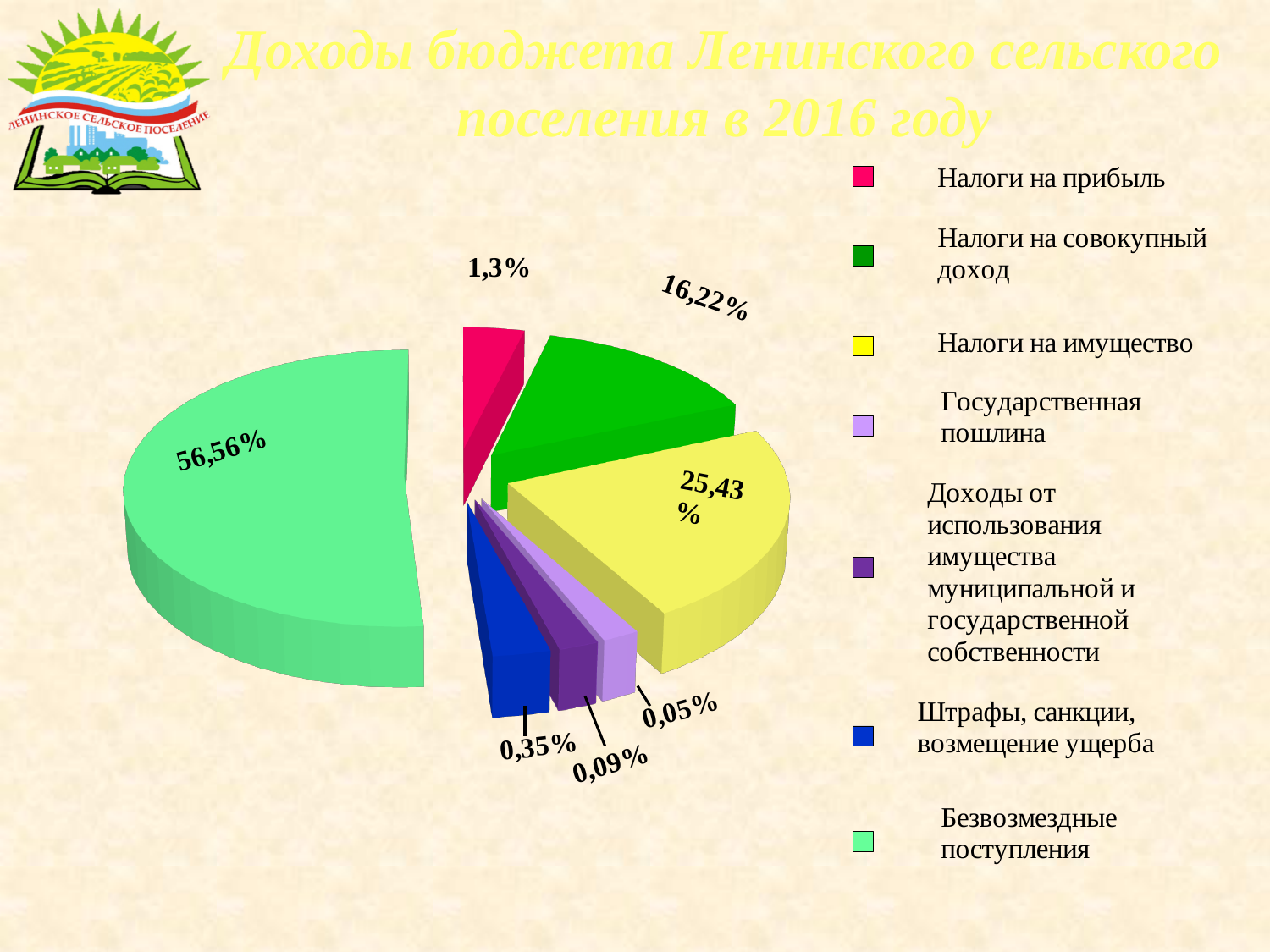
What is the value shown for "Налоги на прибыль"? 1,3% What is the value shown for "Штрафы, санкции, возмещение ущерба"? 0,35% What share of the pie does "Безвозмездные поступления" have? 56,56% What is the difference between the shares of "Налоги на имущество" and "Налоги на совокупный доход"? 9,21% What is the value shown for "Налоги на имущество"? 25,43% Which category has the largest share of the pie? Безвозмездные поступления What is the value shown for "Налоги на совокупный доход"? 16,22% Which category has the smallest share of the pie? Государственная пошлина What kind of chart is shown on the slide? Pie chart Which is larger: "Налоги на имущество" or "Налоги на совокупный доход"? Налоги на имущество What is the value shown for "Государственная пошлина"? 0,05% How many entries does the legend list? 7